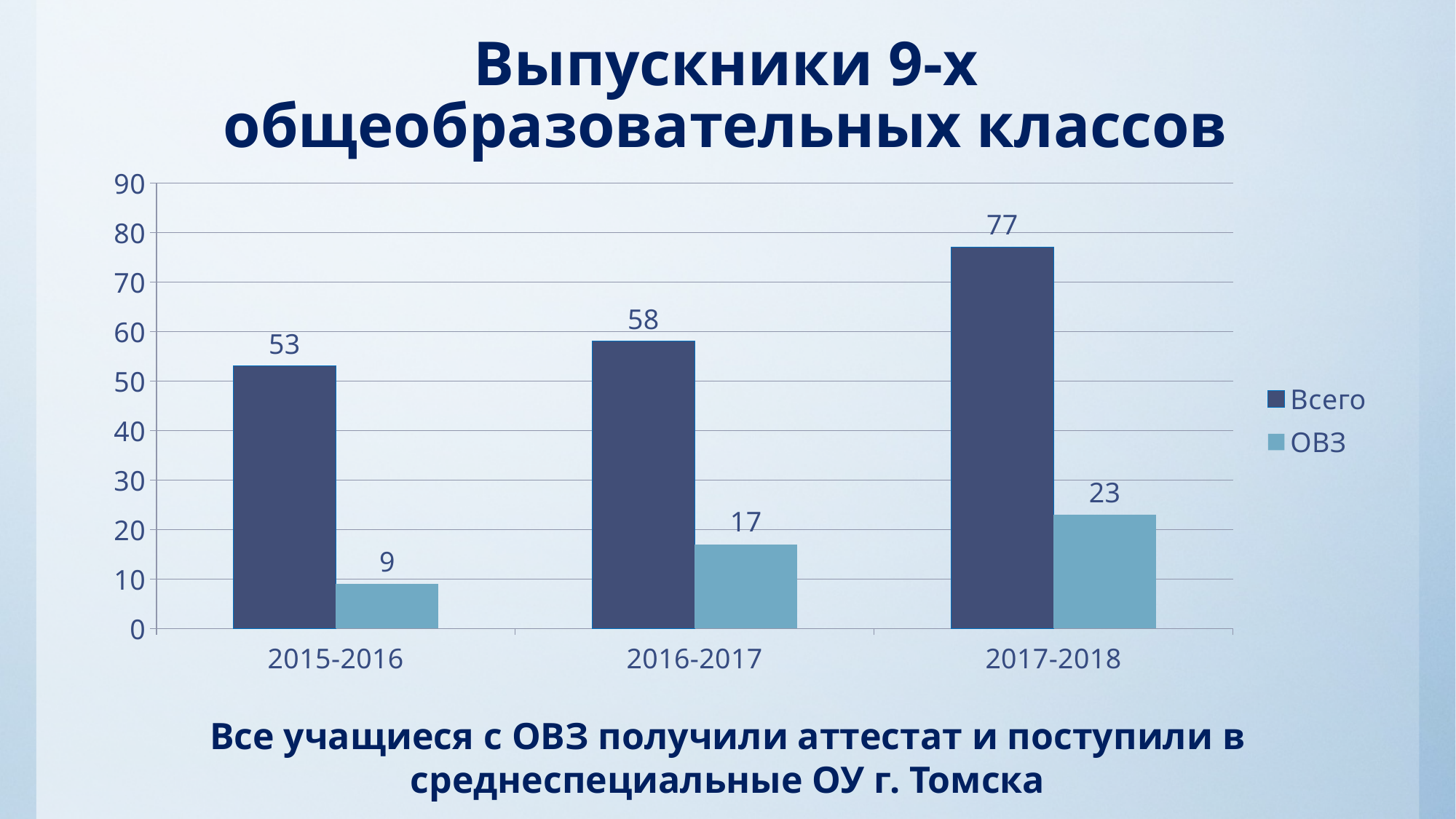
Which year has the highest value for Всего? 2017-2018 What kind of chart is shown on the slide? bar chart What is the value for ОВЗ in 2017-2018? 23 Do the Всего values rise or fall from 2015-2016 to 2017-2018? rise What is the difference between the Всего values for 2016-2017 and 2015-2016? 5 What is the difference between Всего and ОВЗ in 2017-2018? 54 How many years are shown on the x axis? 3 What is the value for Всего in 2015-2016? 53 How many series does the legend list? 2 Which year has the lowest value for ОВЗ? 2015-2016 What is the value for ОВЗ in 2016-2017? 17 Which is larger: ОВЗ in 2016-2017 or ОВЗ in 2015-2016? ОВЗ in 2016-2017